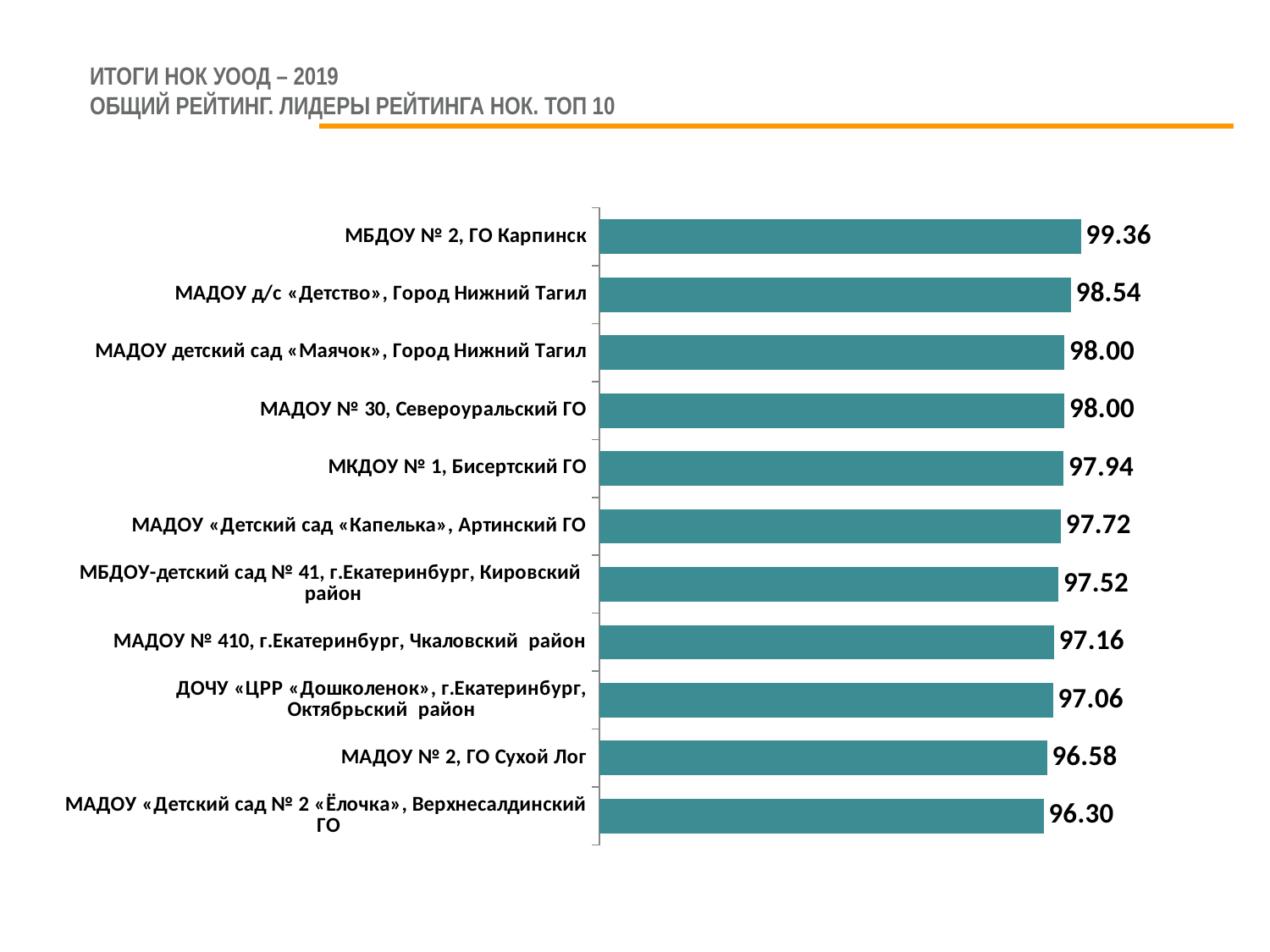
What value is shown for МБДОУ № 2, ГО Карпинск? 99.36 Which category has the highest value? МБДОУ № 2, ГО Карпинск Which has a larger value: МАДОУ «Детский сад «Капелька», Артинский ГО or ДОЧУ «ЦРР «Дошколенок», г.Екатеринбург, Октябрьский район? МАДОУ «Детский сад «Капелька», Артинский ГО What value is shown for МАДОУ № 410, г.Екатеринбург, Чкаловский район? 97.16 What value is shown for МКДОУ № 1, Бисертский ГО? 97.94 What is the difference between the values for МАДОУ д/с «Детство», Город Нижний Тагил and МАДОУ № 30, Североуральский ГО? 0.54 Do the values increase or decrease going from the top bar to the bottom bar? Decrease Which category has the lowest value? МАДОУ «Детский сад № 2 «Ёлочка», Верхнесалдинский ГО How many bars are plotted on the chart? 11 What kind of chart is shown on the slide? Bar chart What value is shown for МАДОУ № 2, ГО Сухой Лог? 96.58 What is the difference between the values for МБДОУ № 2, ГО Карпинск and МАДОУ «Детский сад № 2 «Ёлочка», Верхнесалдинский ГО? 3.06